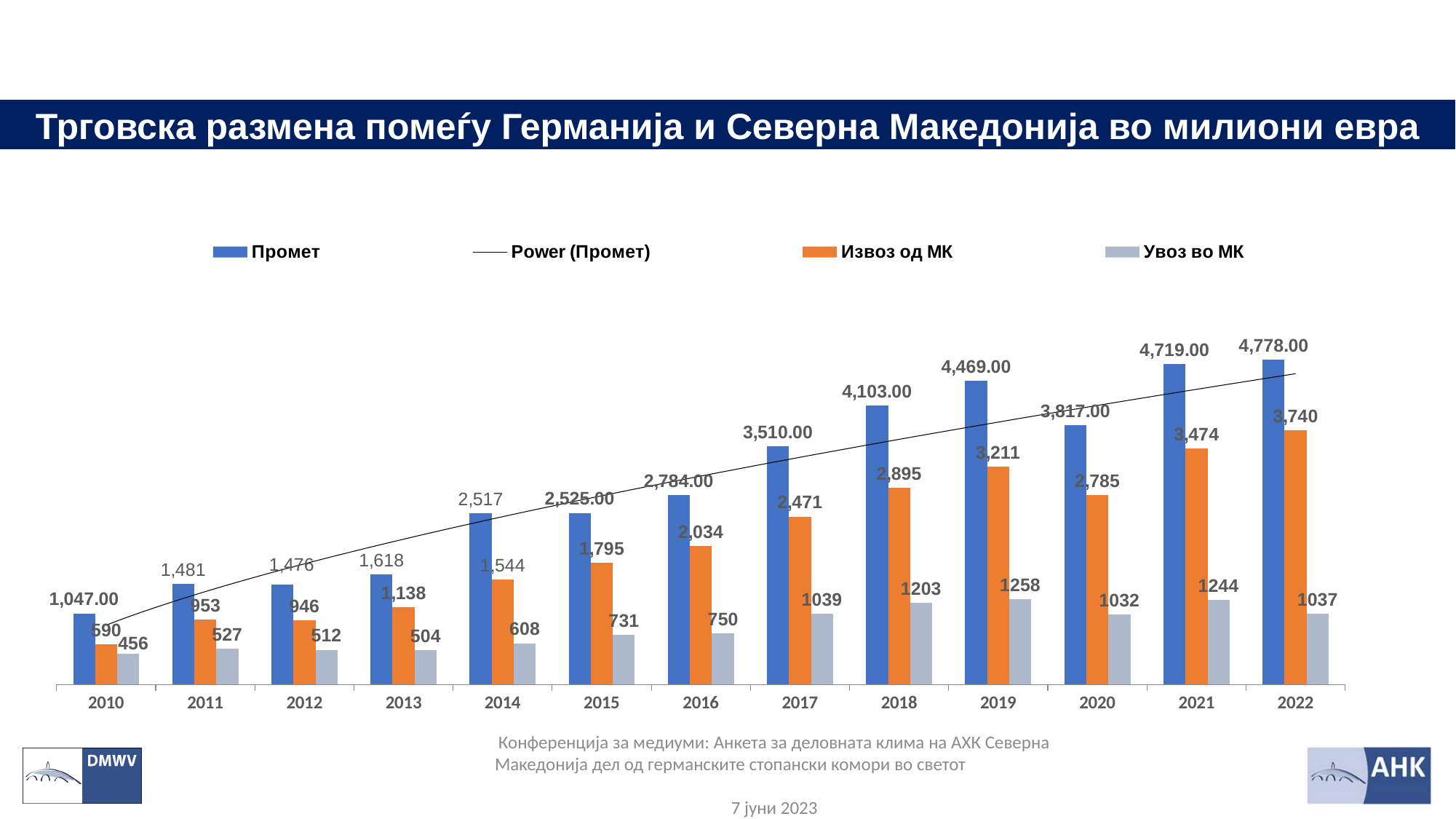
How many entries does the legend list? 4 What is the value of Промет for 2022? 4,778.00 In which year is Увоз во МК highest? 2019 What is the value of Извоз од МК for 2017? 2,471 Which is larger: Увоз во МК in 2018 or in 2021? 2021 What is the difference between Извоз од МК and Увоз во МК in 2022? 2,703 In which year is Извоз од МК lowest? 2010 Does Промет generally rise or fall from 2010 to 2022? rise What is the value of Увоз во МК for 2014? 608 What type of chart is shown on the slide? bar chart What is the value of Промет for 2020? 3,817.00 How many years are shown on the x axis? 13